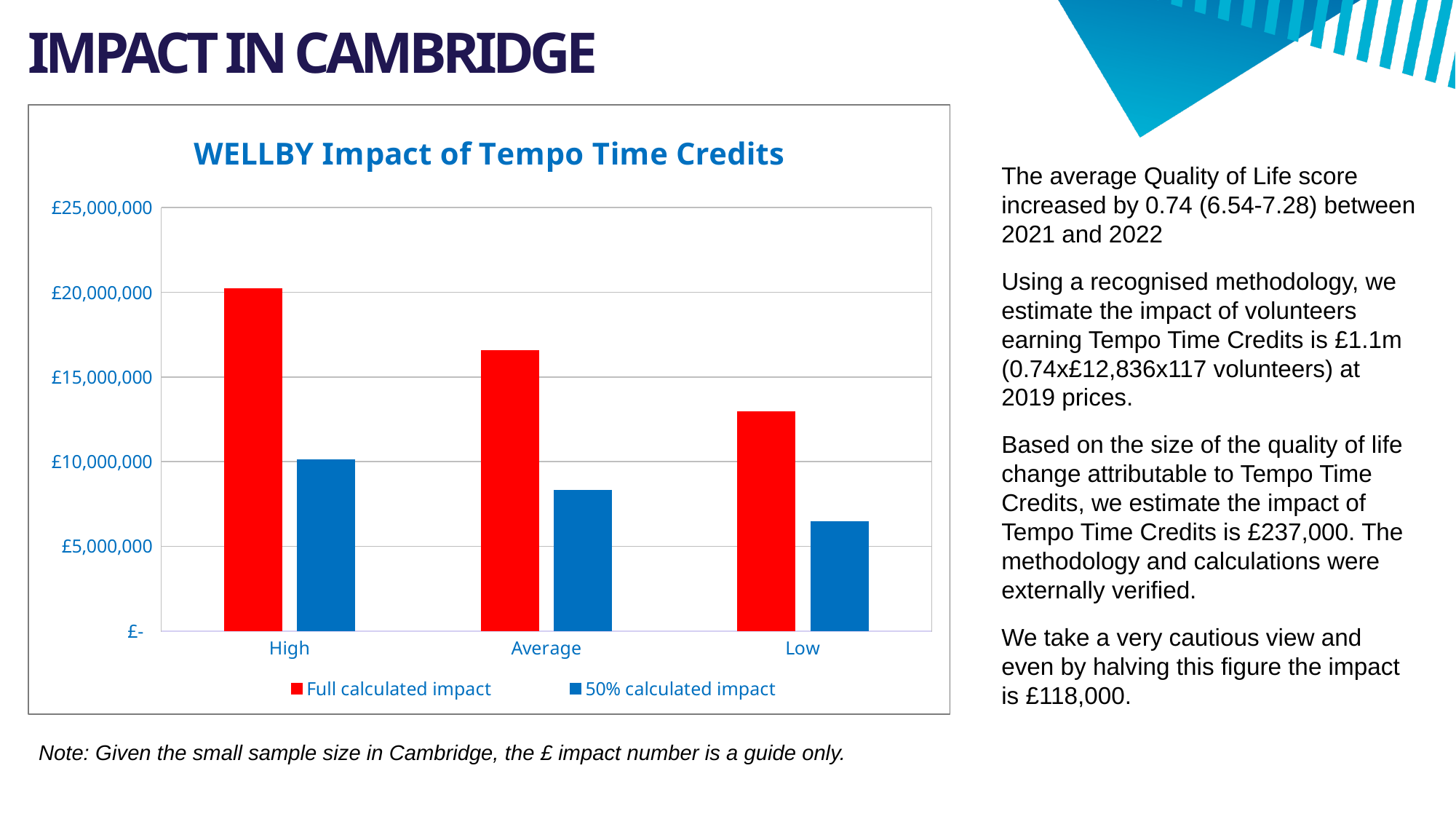
How many categories are shown on the x axis of the chart? 3 Is the 50% calculated impact for Average greater or less than £10,000,000? less What kind of chart is shown on the slide? bar chart Is the Full calculated impact for Average greater or less than £15,000,000? greater Do the Full calculated impact values rise or fall from High to Low along the x axis? fall Which category has the highest Full calculated impact? High Is the Full calculated impact for Low greater or less than £15,000,000? less Which category has the lowest 50% calculated impact? Low Which is larger: the Full calculated impact for Low or the 50% calculated impact for High? Full calculated impact for Low How many series does the chart legend list? 2 What is the title of the chart? WELLBY Impact of Tempo Time Credits